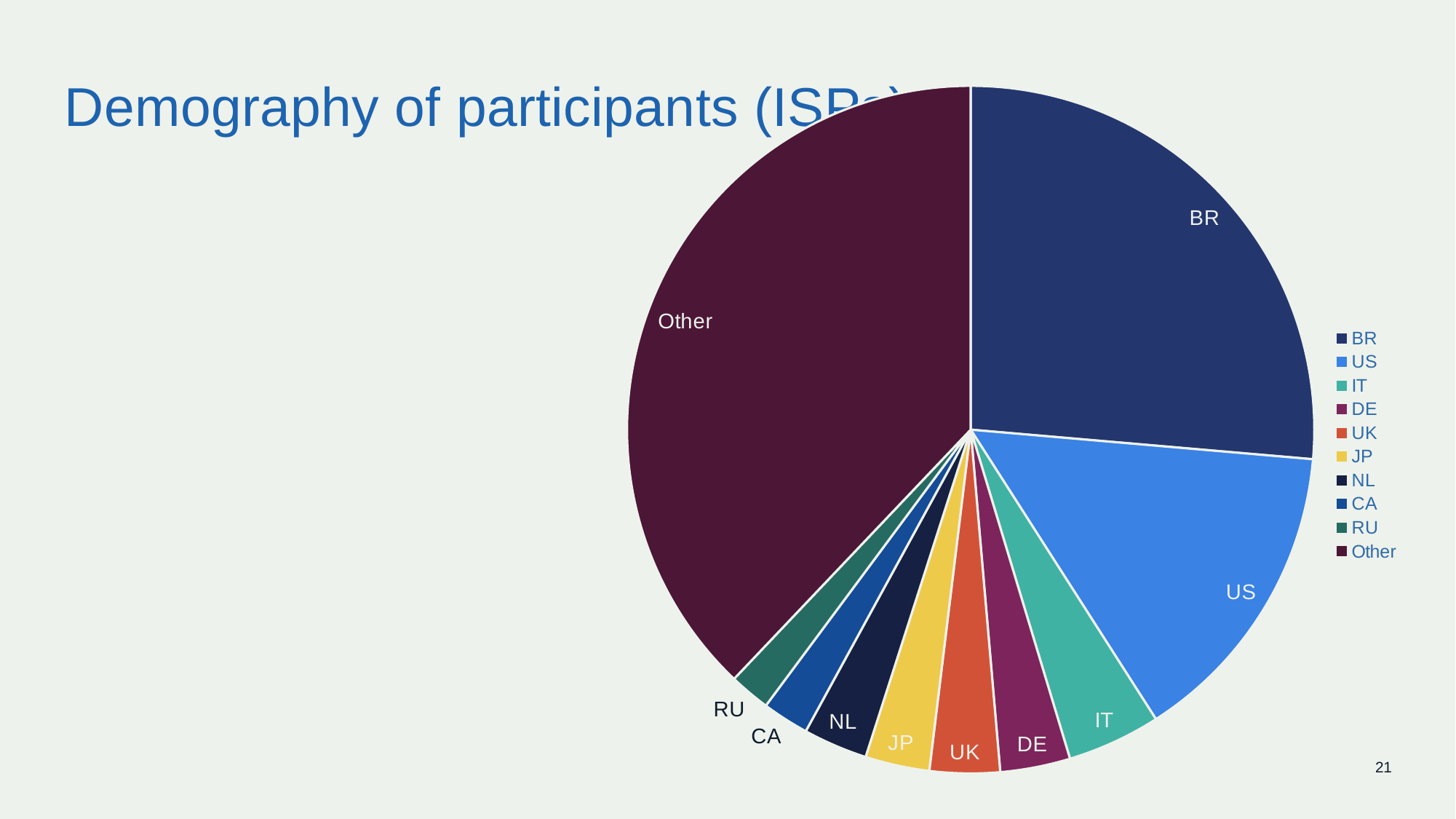
What is the first entry listed in the legend? BR How many entries does the legend list? 10 How many slices does the pie chart have? 10 Which slice is larger, US or JP? US Which slice is larger, US or IT? US Which category has the largest slice of the pie? Other Which is the largest slice among the named countries (excluding Other)? BR On which side of the chart is the legend placed? right Which slice is larger, Other or BR? Other What kind of chart is shown on the slide? pie chart